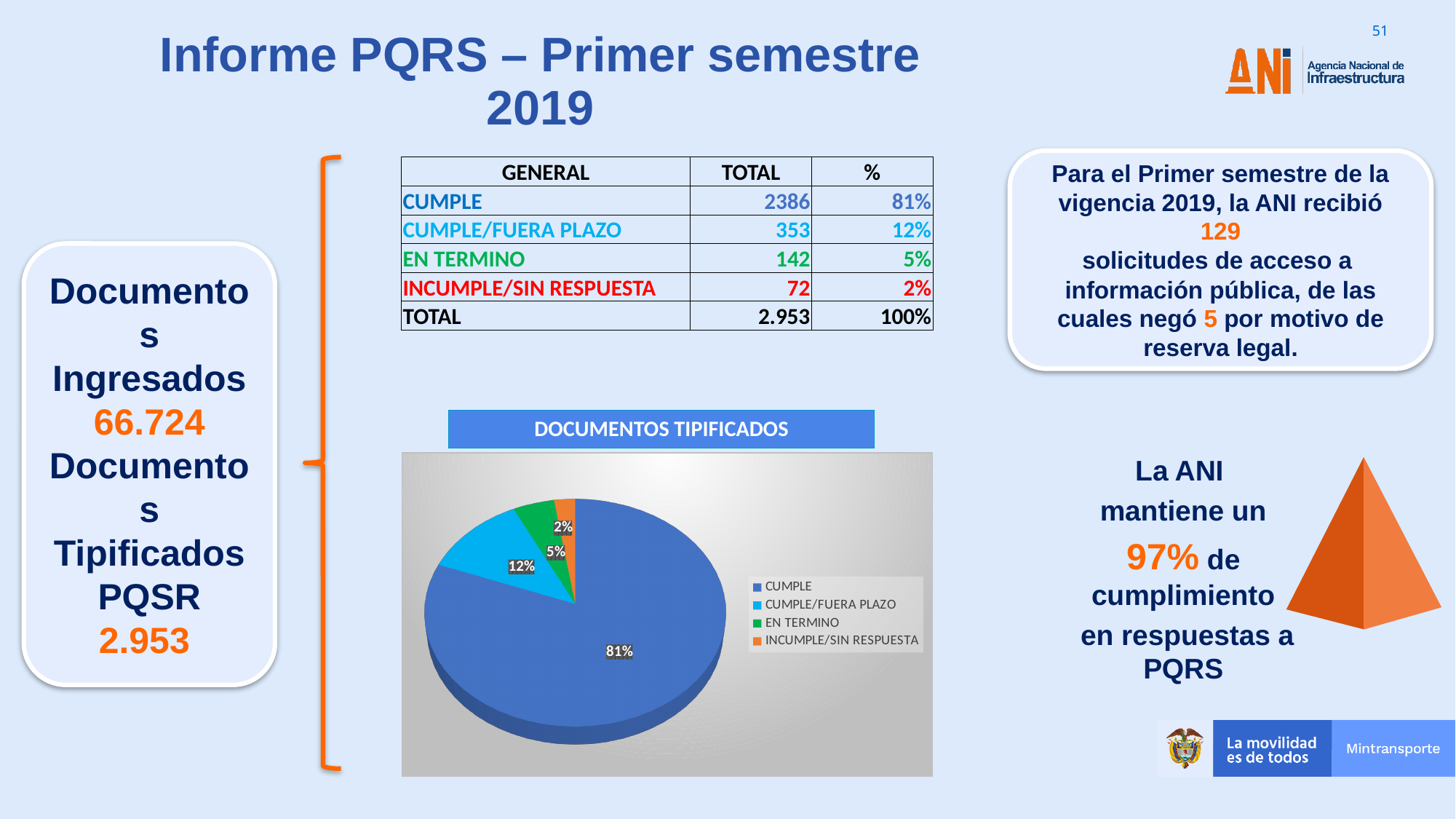
Which category has the largest slice in the DOCUMENTOS TIPIFICADOS pie chart? CUMPLE What colour is the EN TERMINO slice in the DOCUMENTOS TIPIFICADOS pie chart? Green What kind of chart is shown under the heading DOCUMENTOS TIPIFICADOS? Pie chart In the DOCUMENTOS TIPIFICADOS pie chart, what share does CUMPLE/FUERA PLAZO have? 12% In the DOCUMENTOS TIPIFICADOS pie chart, what share does EN TERMINO have? 5% How many slices does the DOCUMENTOS TIPIFICADOS pie chart have? 4 In the DOCUMENTOS TIPIFICADOS pie chart, what is the difference in percentage points between the CUMPLE slice and the CUMPLE/FUERA PLAZO slice? 69% In the DOCUMENTOS TIPIFICADOS pie chart, what share does CUMPLE have? 81% How many entries does the legend of the DOCUMENTOS TIPIFICADOS pie chart list? 4 In the DOCUMENTOS TIPIFICADOS pie chart, which slice is larger: CUMPLE/FUERA PLAZO or EN TERMINO? CUMPLE/FUERA PLAZO Which category has the smallest slice in the DOCUMENTOS TIPIFICADOS pie chart? INCUMPLE/SIN RESPUESTA